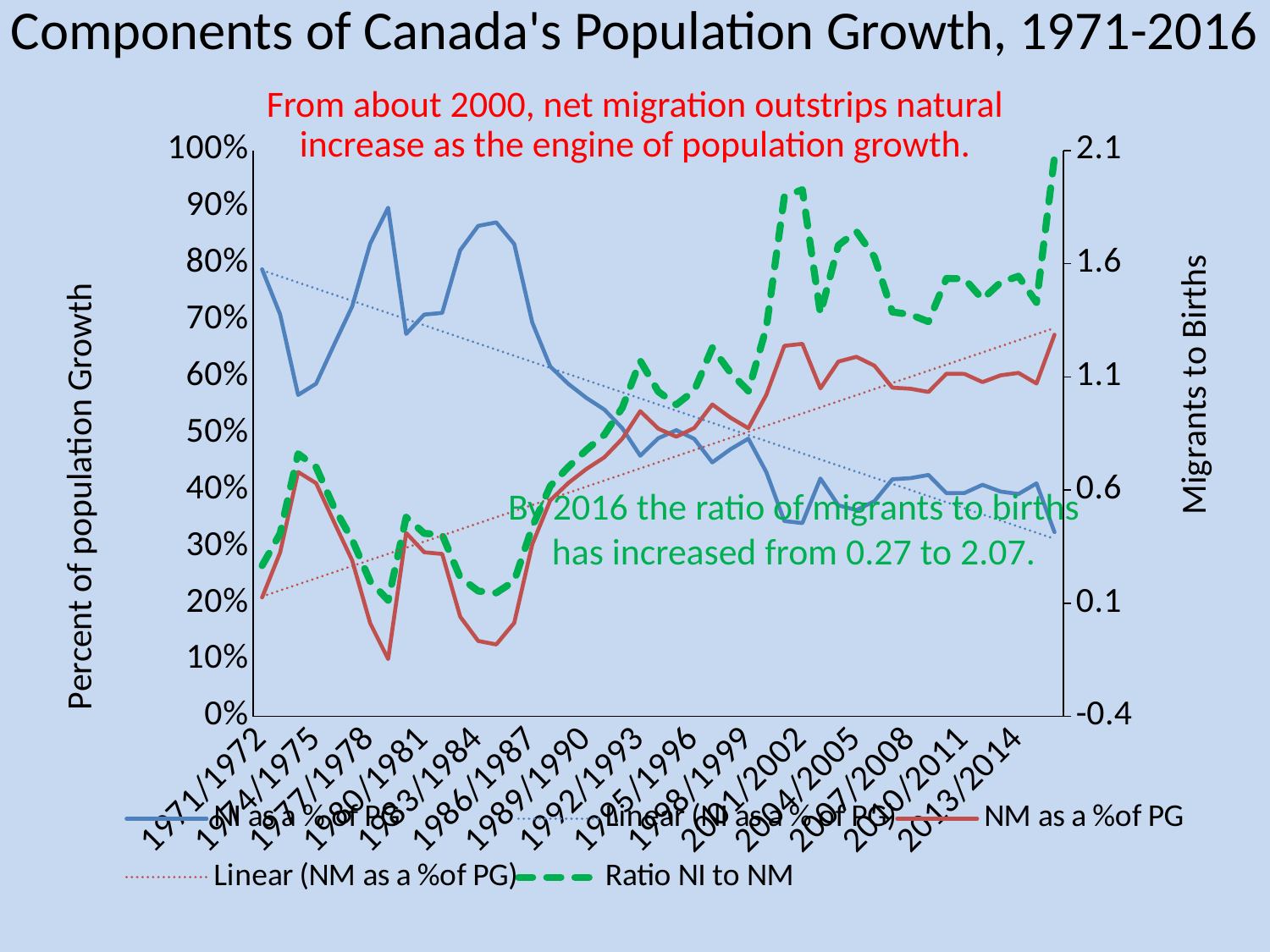
Does NM as a % of PG generally rise or fall from 1971/1972 to the end of the series? rise Is the value of NI as a % of PG in 1983/1984 greater or less than 80%? greater Is the value of NI as a % of PG in 1971/1972 greater or less than 70%? greater According to the annotation on the chart, what is the ratio of migrants to births by 2016? 2.07 What is the title of the left vertical axis? Percent of population Growth How many series does the legend list? 5 What kind of chart is shown on the slide? line chart What is the title of the chart? Components of Canada's Population Growth, 1971-2016 Does NI as a % of PG generally rise or fall from 1971/1972 to the end of the series? fall Is the value of NM as a % of PG in 1971/1972 greater or less than 30%? less In 2013/2014, which is larger: NI as a % of PG or NM as a % of PG? NM as a % of PG In 1971/1972, which is larger: NI as a % of PG or NM as a % of PG? NI as a % of PG